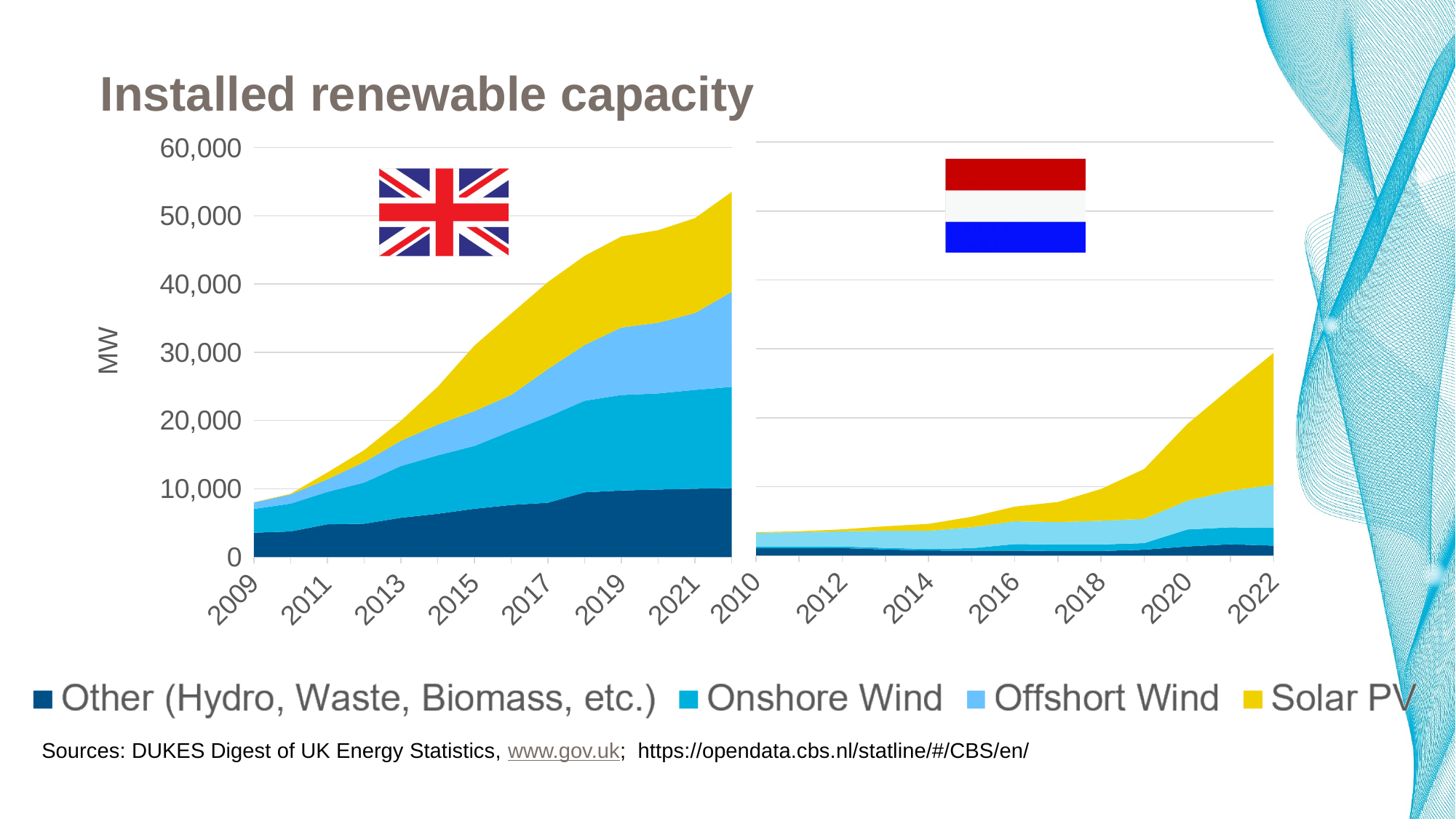
In the right (Netherlands) chart, is the total installed capacity in 2010 greater or less than 10,000? less How many series does the legend list? 4 What unit is shown on the y axis? MW In the left (UK) chart, is the total installed capacity in 2009 greater or less than 10,000? less What is the title of the slide's chart? Installed renewable capacity What kind of chart is used on this slide? Stacked area chart In the left (UK) chart, does total installed capacity rise or fall from 2009 to 2022? rise In the left (UK) chart, is the total installed capacity in 2022 greater or less than 50,000? greater Which country has the larger total installed renewable capacity in 2022, the UK (left chart) or the Netherlands (right chart)? UK In the right (Netherlands) chart, which series contributes the most capacity in 2022? Solar PV